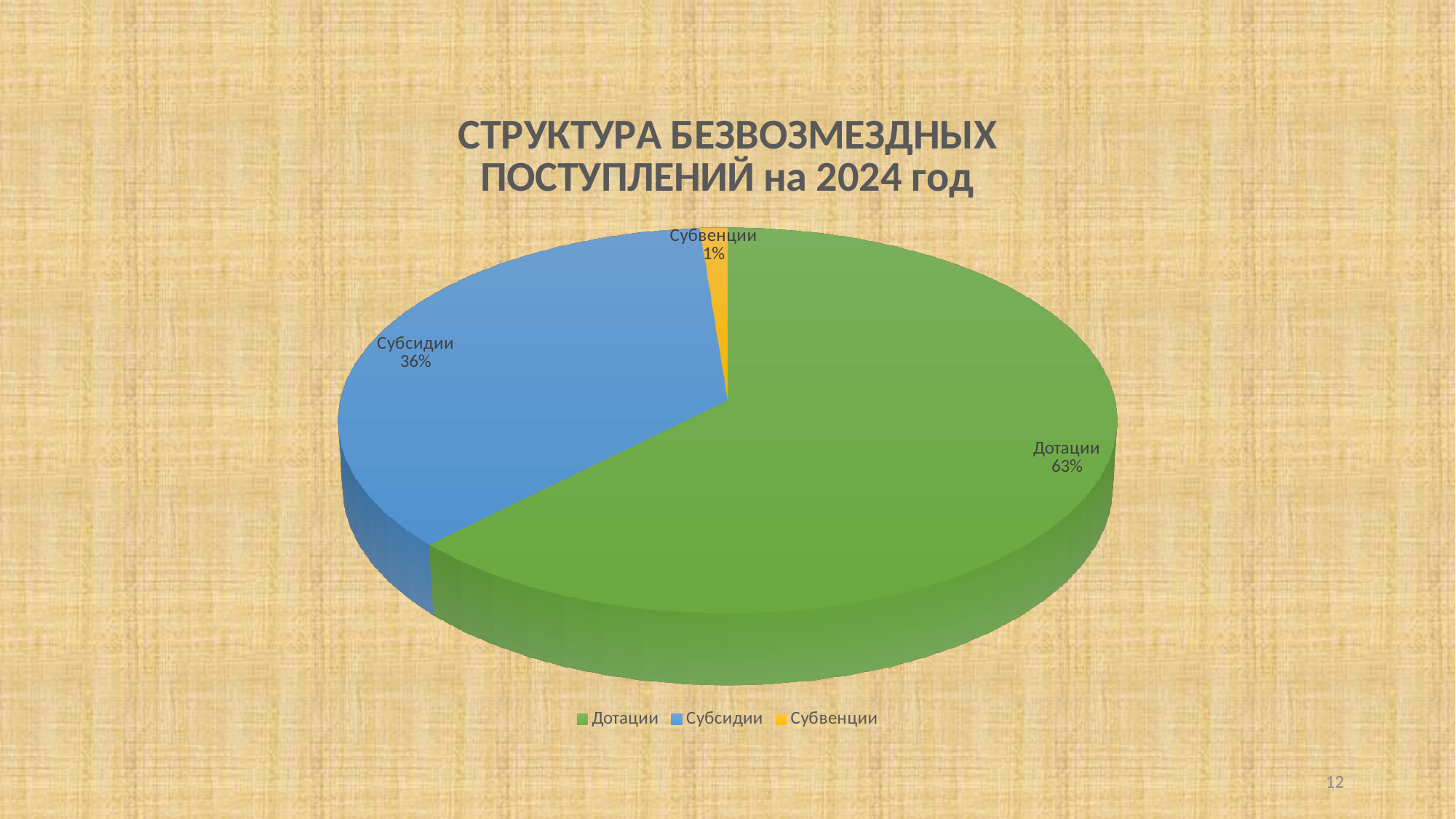
What kind of chart is shown on the slide? Pie chart What is the title of the chart? СТРУКТУРА БЕЗВОЗМЕЗДНЫХ ПОСТУПЛЕНИЙ на 2024 год What share of the pie does Дотации have? 63% How many entries does the legend list? 3 What colour represents Субсидии in the chart? Blue How many categories are shown in the pie chart? 3 Which category has the largest share of the pie? Дотации What share of the pie does Субвенции have? 1% What is the difference in percentage points between the shares of Дотации and Субсидии? 27 Which is larger, the share of Субсидии or the share of Субвенции? Субсидии What share of the pie does Субсидии have? 36% Which category has the smallest share of the pie? Субвенции